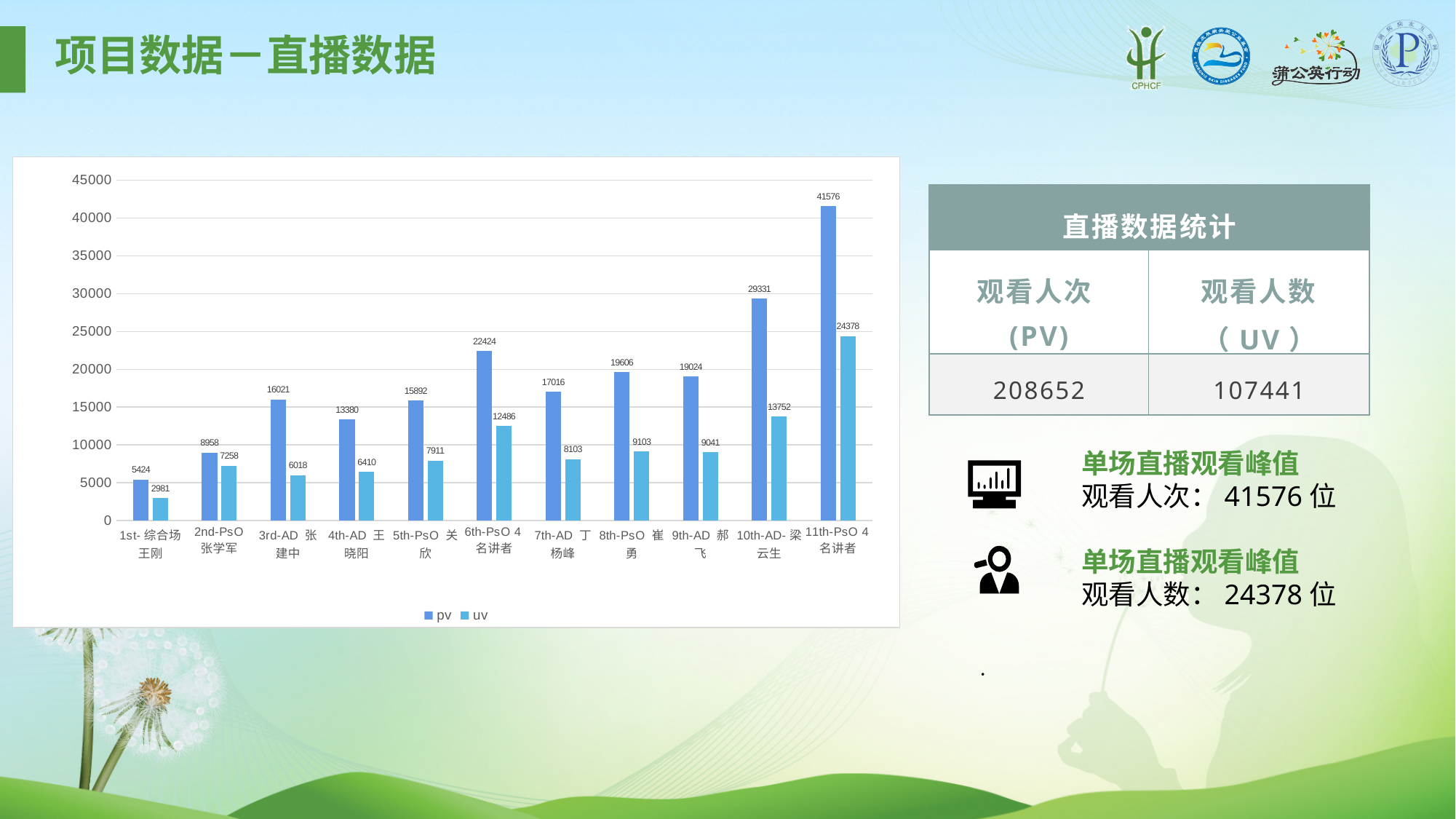
How many categories are shown on the x axis of the chart? 11 Which category has the lowest uv value? 1st-综合场 王刚 What is the pv value for 10th-AD-梁云生? 29331 What are the two series names listed in the chart legend? pv and uv What is the pv value for 1st-综合场 王刚? 5424 Which category has the highest pv value? 11th-PsO 4名讲者 What kind of chart is shown on the slide? bar chart What is the difference between the pv and uv values for 11th-PsO 4名讲者? 17198 Which is larger, the pv value for 8th-PsO 崔勇 or the pv value for 9th-AD 郝飞? 8th-PsO 崔勇 Is the pv value for 3rd-AD 张建中 greater or less than 15000? greater What is the uv value for 6th-PsO 4名讲者? 12486 How many series does the chart legend list? 2